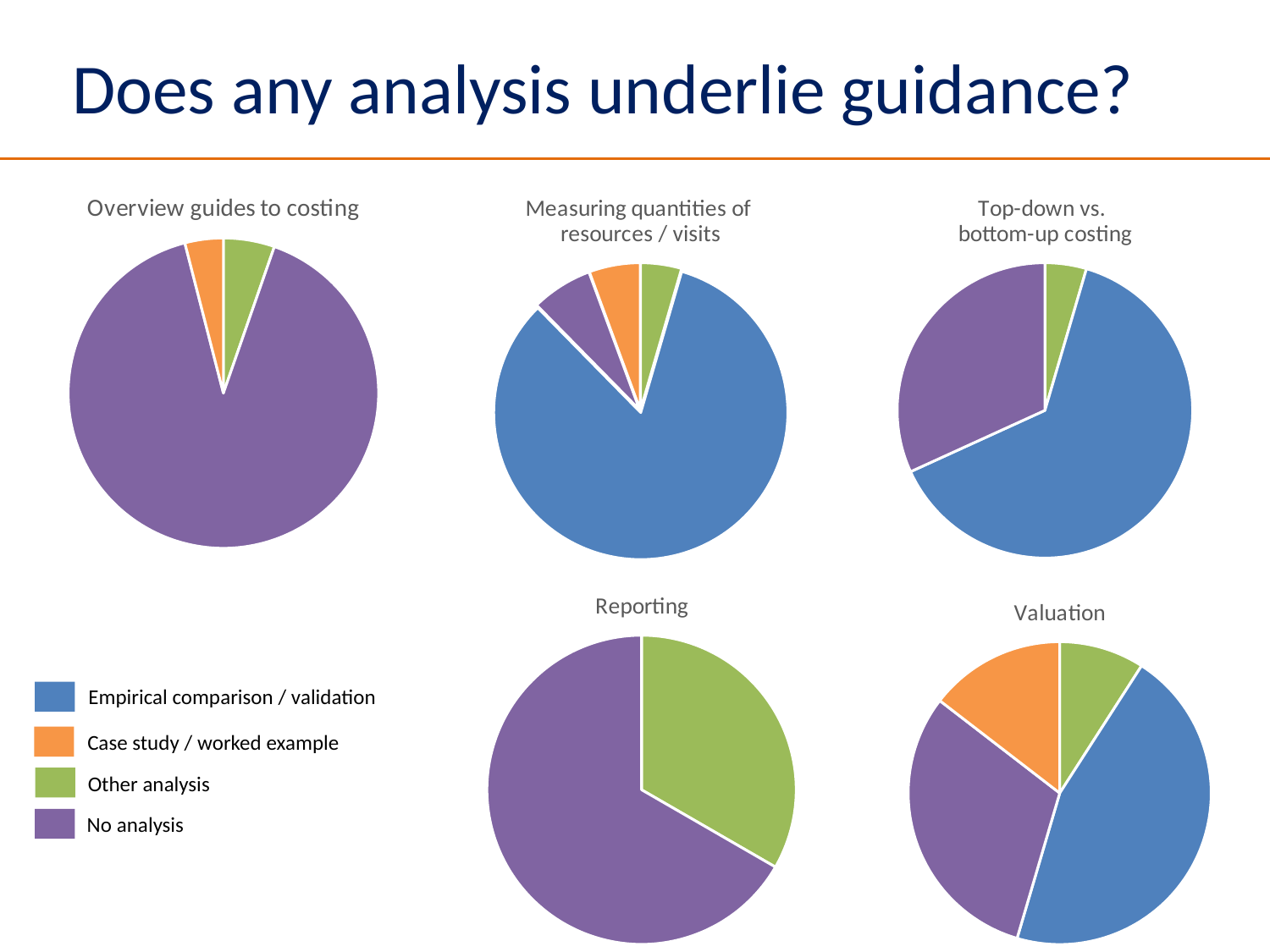
How many categories does the legend list? 4 In the 'Overview guides to costing' chart, which category has the largest slice? No analysis How many pie charts are on the slide? 5 Which colour represents 'No analysis' in the legend? Purple In the 'Valuation' chart, which is larger: Case study / worked example or Other analysis? Case study / worked example What kind of charts are shown on the slide? Pie charts In the 'Valuation' chart, which category has the largest slice? Empirical comparison / validation In the 'Top-down vs. bottom-up costing' chart, which category has the largest slice? Empirical comparison / validation In the 'Top-down vs. bottom-up costing' chart, which category has the smallest slice? Other analysis In the 'Reporting' chart, how many slices are there? 2 In the 'Reporting' chart, which is larger: No analysis or Other analysis? No analysis